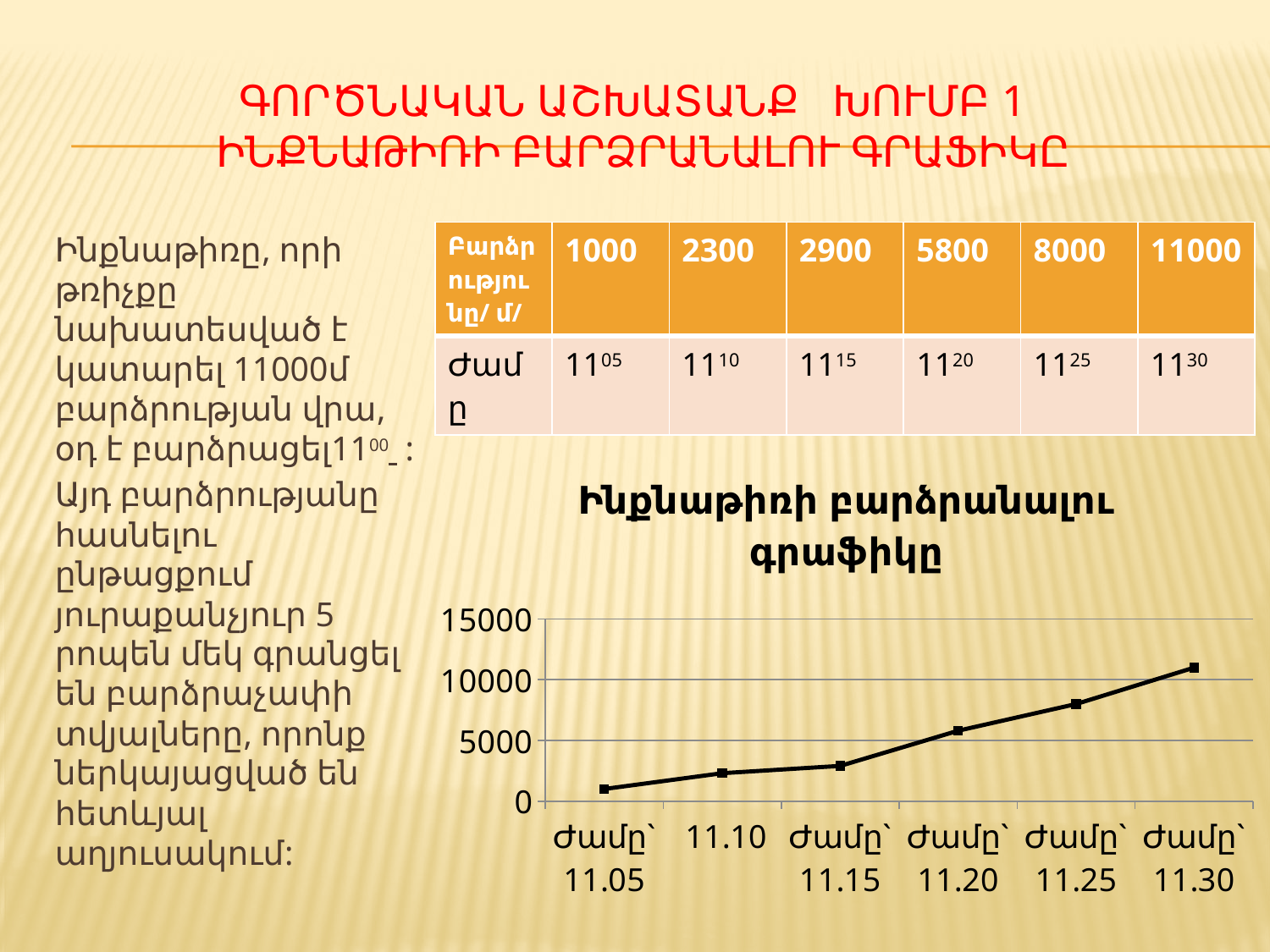
Which has the larger value on the line chart, Ժամը` 11.15 or Ժամը` 11.25? Ժամը` 11.25 At which time does the line chart show its lowest value? Ժամը` 11.05 At which time does the line chart reach its highest value? Ժամը` 11.30 What is the title of the line chart? Ինքնաթիռի բարձրանալու գրաֆիկը Is the value for Ժամը` 11.05 greater or less than 5000? less Do the values on the line chart rise or fall from left to right along the x axis? rise Is the value for Ժամը` 11.30 greater or less than 10000? greater How many data points are plotted on the line chart? 6 Is the value for Ժամը` 11.25 greater or less than 10000? less What kind of chart is shown on the slide? line chart What is the highest tick value shown on the y axis of the line chart? 15000